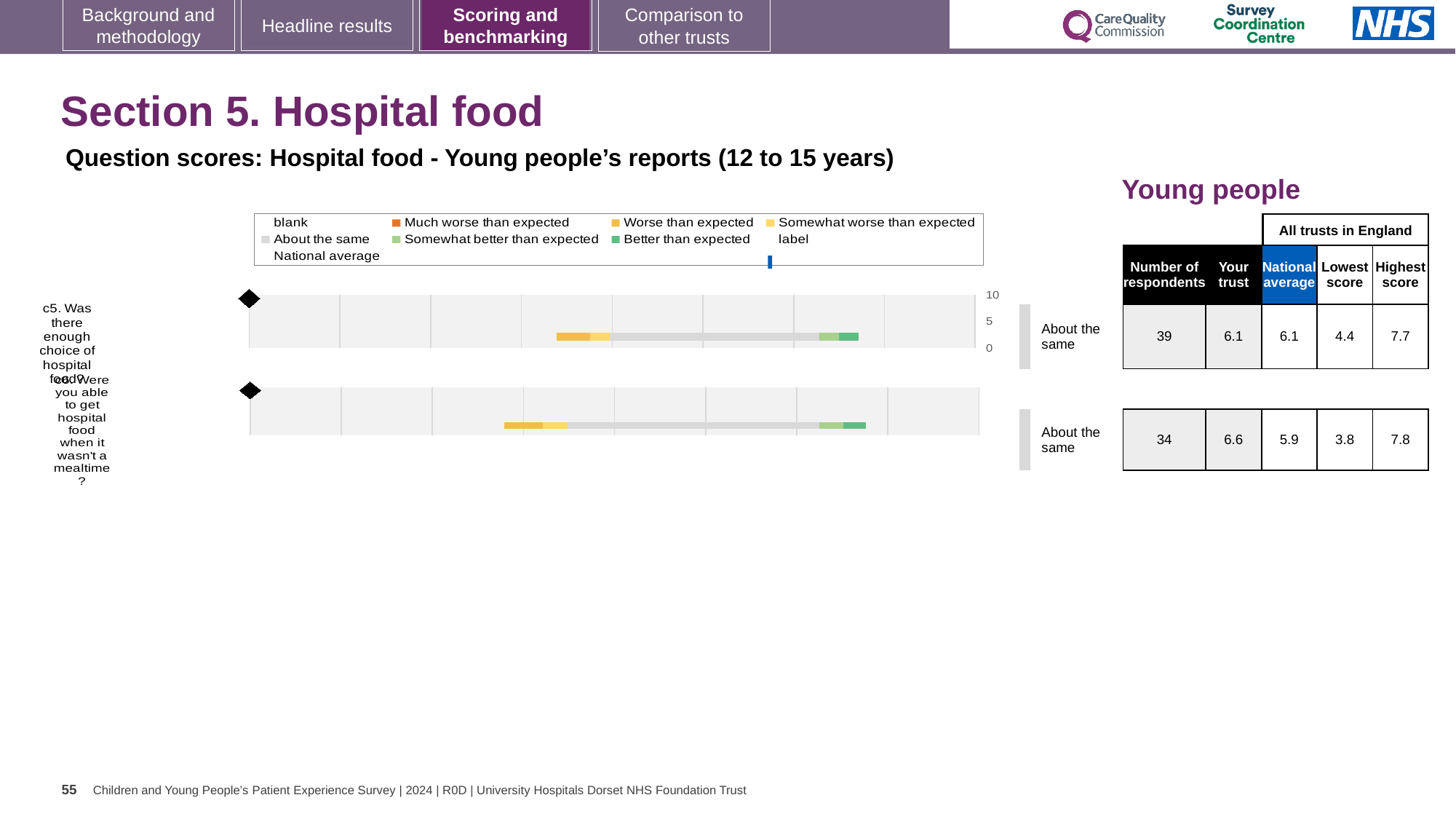
What is the highest score among all trusts in England for c6? 7.8 In the legend, what colour represents 'Much worse than expected'? orange Which question has the higher 'Your trust' score, c5 or c6? c6 What is the 'Your trust' score for c5 'Was there enough choice of hospital food?'? 6.1 What is the highest value shown on the chart's score axis? 10 What kind of chart is used to show the question scores for hospital food? bar chart What is the national average score for c6 'Were you able to get hospital food when it wasn't a mealtime?'? 5.9 What is the difference between the 'Your trust' score and the national average for c6? 0.7 What is the lowest score among all trusts in England for c5? 4.4 How many respondents answered question c5? 39 What benchmark category is shown next to the bar for c5? About the same How many questions (bars) are plotted in the hospital food chart? 2